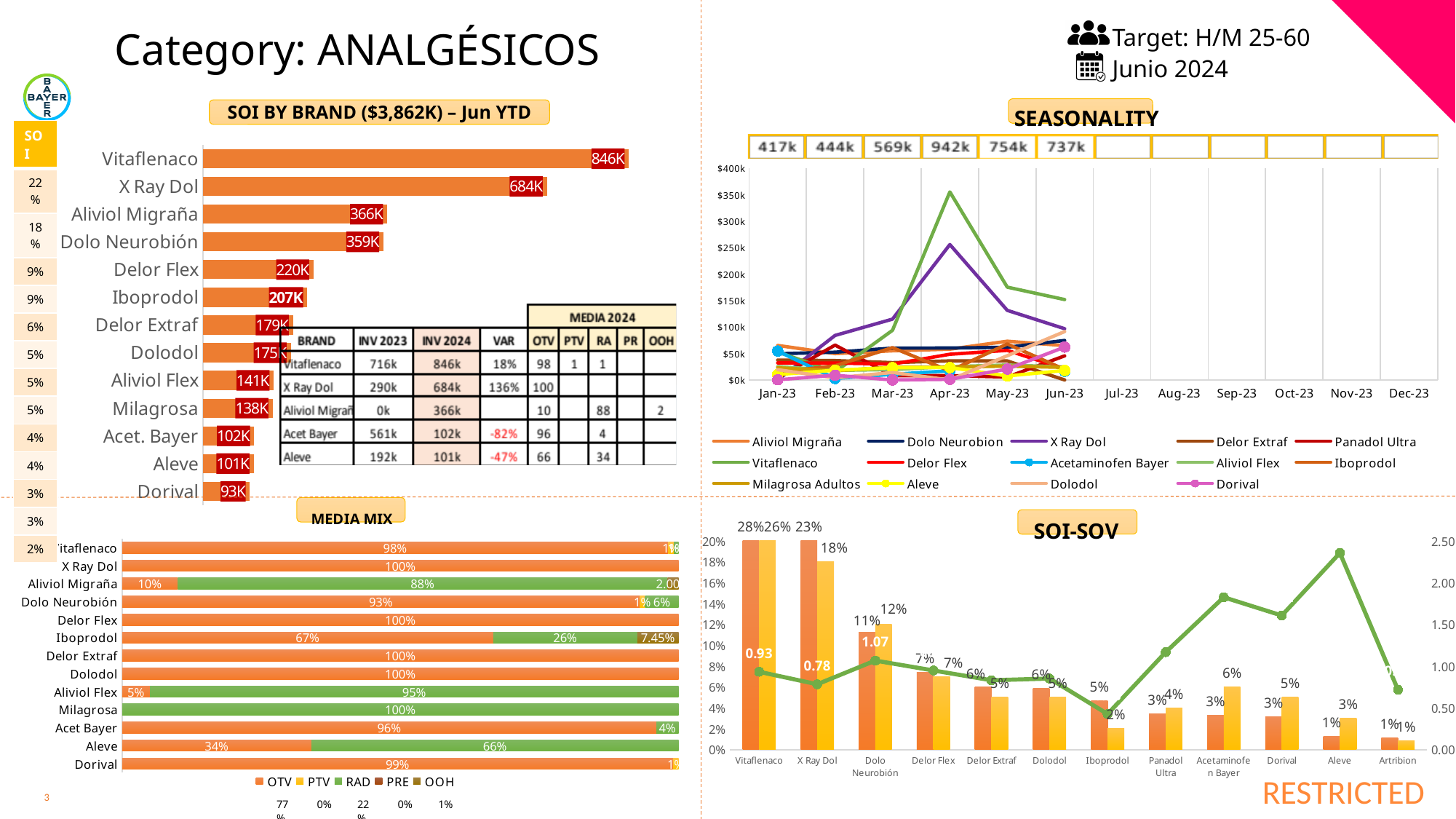
In the SEASONALITY chart, is the Vitaflenaco value in Apr-23 greater or less than $300k? greater In the SOI BY BRAND chart, which brand has the lowest SOI? Dorival In the SEASONALITY chart, which month has the highest total shown in the row above the plot? Apr-23 How many brands are shown in the SOI BY BRAND chart? 13 In the MEDIA MIX chart, what is the RAD share for Aleve? 66% In the SOI BY BRAND chart, what is the difference between X Ray Dol and Aliviol Migraña? 318K How many series does the legend of the SEASONALITY chart list? 14 In the SOI-SOV chart, which brand has the highest value on the green line? Aleve In the SOI BY BRAND chart, what is the value for Vitaflenaco? 846K What kind of chart is the SEASONALITY chart? Line chart In the MEDIA MIX chart, what is the OTV share for Iboprodol? 67% In the SOI-SOV chart, what is the labelled line value for Dolo Neurobión? 1.07